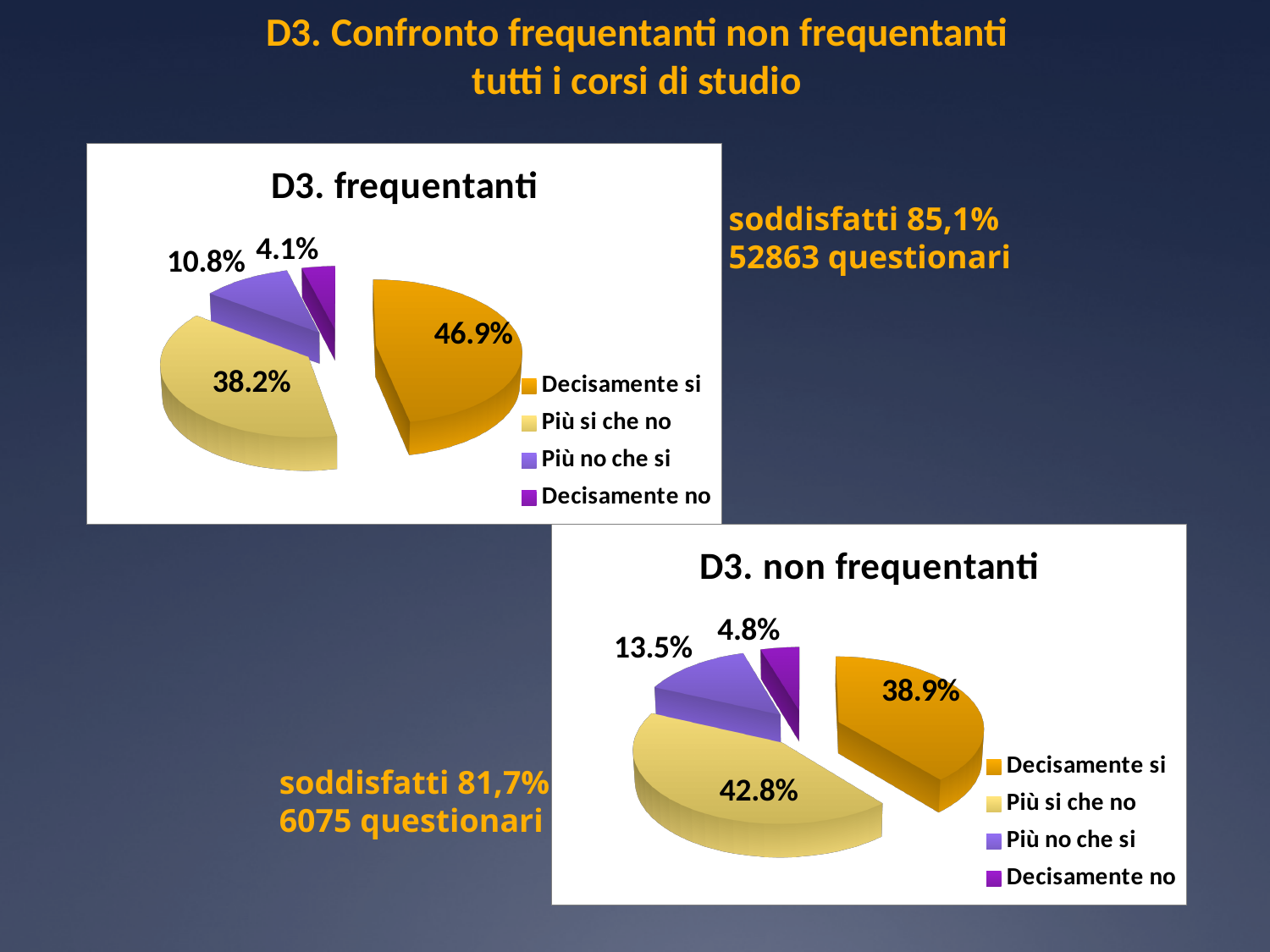
How many categories does the legend of the "D3. frequentanti" chart list? 4 In the "D3. non frequentanti" chart, what percentage is shown for "Più si che no"? 42.8% In the "D3. non frequentanti" chart, what is the difference between "Più si che no" and "Decisamente si"? 3.9% In the "D3. frequentanti" chart, which category has the largest slice? Decisamente si In the "D3. non frequentanti" chart, what percentage is shown for "Decisamente no"? 4.8% Which chart has the larger value for "Più no che si", "D3. frequentanti" or "D3. non frequentanti"? D3. non frequentanti In the "D3. frequentanti" chart, which category has the smallest slice? Decisamente no In the "D3. frequentanti" chart, what is the difference between "Decisamente si" and "Più si che no"? 8.7% In the "D3. non frequentanti" chart, which category has the largest slice? Più si che no What type of chart is "D3. non frequentanti"? Pie chart In the "D3. frequentanti" chart, what percentage is shown for "Decisamente si"? 46.9% In the "D3. frequentanti" chart, what percentage is shown for "Più no che si"? 10.8%